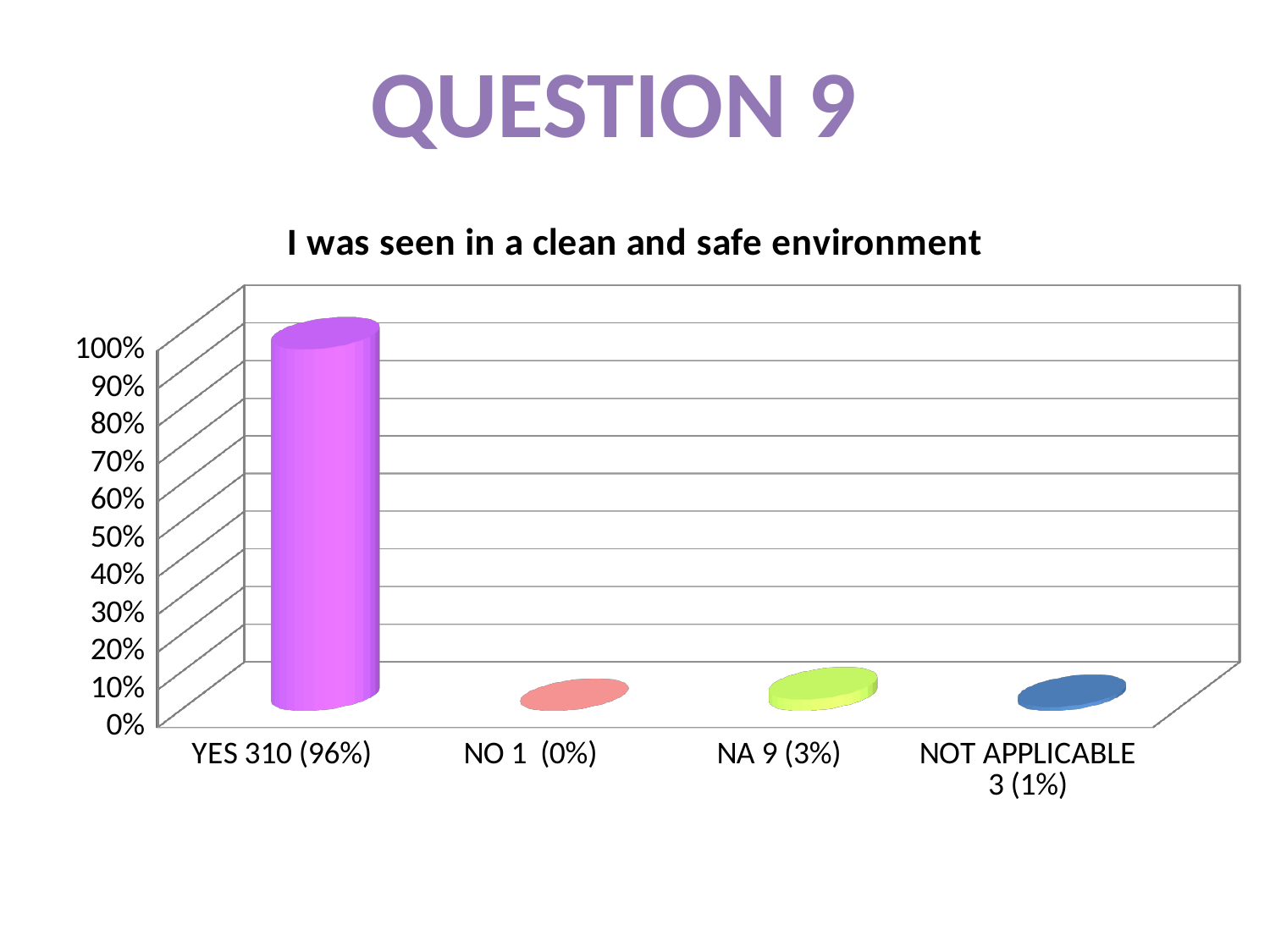
Which category has the highest value? YES Which category has the lowest value? NO Is the value for YES greater or less than 90%? greater How many responses are shown for the NA category? 9 What percentage is shown for the NOT APPLICABLE category? 1% Which is larger, the value for NA or the value for NOT APPLICABLE? NA What is the title of the chart? I was seen in a clean and safe environment What percentage is shown for the YES category? 96% What is the difference in percentage points between the YES and NA categories? 93 How many categories are shown on the x axis of the chart? 4 How many responses are shown for the NO category? 1 What kind of chart is shown on the slide? bar chart